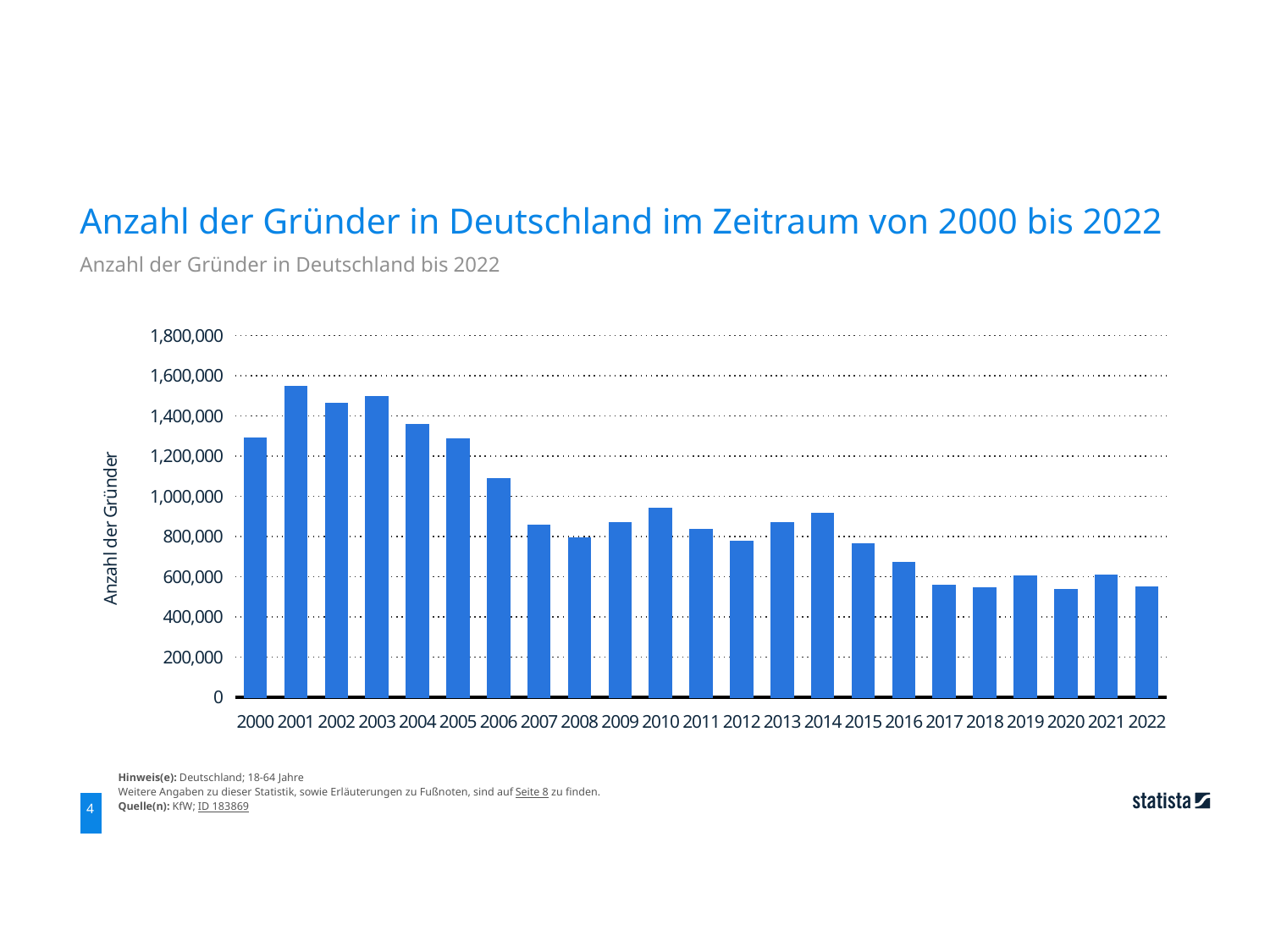
How many years are shown on the x axis of the chart? 23 Which year has the larger value, 2000 or 2006? 2000 Which year has the highest number of founders (Anzahl der Gründer)? 2001 Is the value for 2017 greater or less than 600,000? less What kind of chart is shown on the slide? Bar chart Is the value for 2010 greater or less than 800,000? greater Is the value for 2001 greater or less than 1,400,000? greater What is the label of the y axis? Anzahl der Gründer Which year has the larger value, 2010 or 2011? 2010 Overall, do the values rise or fall from 2000 to 2022? Fall